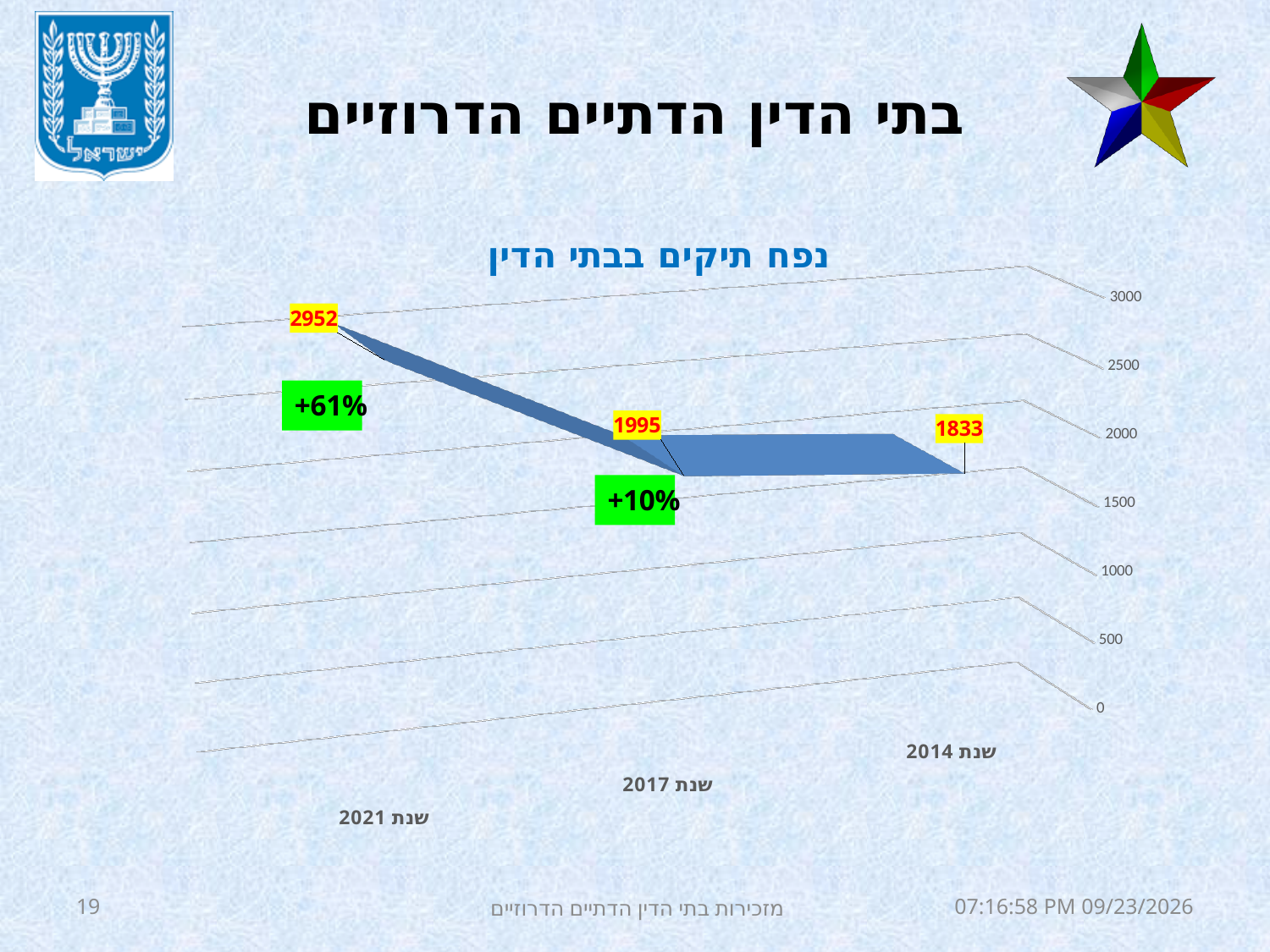
What is the value for שנת 2017? 1995 How many years are plotted on the chart? 3 What is the difference between the values for שנת 2021 and שנת 2017? 957 What is the value for שנת 2021? 2952 Which year has the lowest value? שנת 2014 Which is larger, the value for שנת 2017 or the value for שנת 2014? שנת 2017 What is the difference between the values for שנת 2017 and שנת 2014? 162 Is the value for שנת 2021 greater or less than 2500? greater What is the value for שנת 2014? 1833 What is the title of the chart? נפח תיקים בבתי הדין What percentage change is labelled between שנת 2017 and שנת 2021? +61% Which year has the highest value? שנת 2021